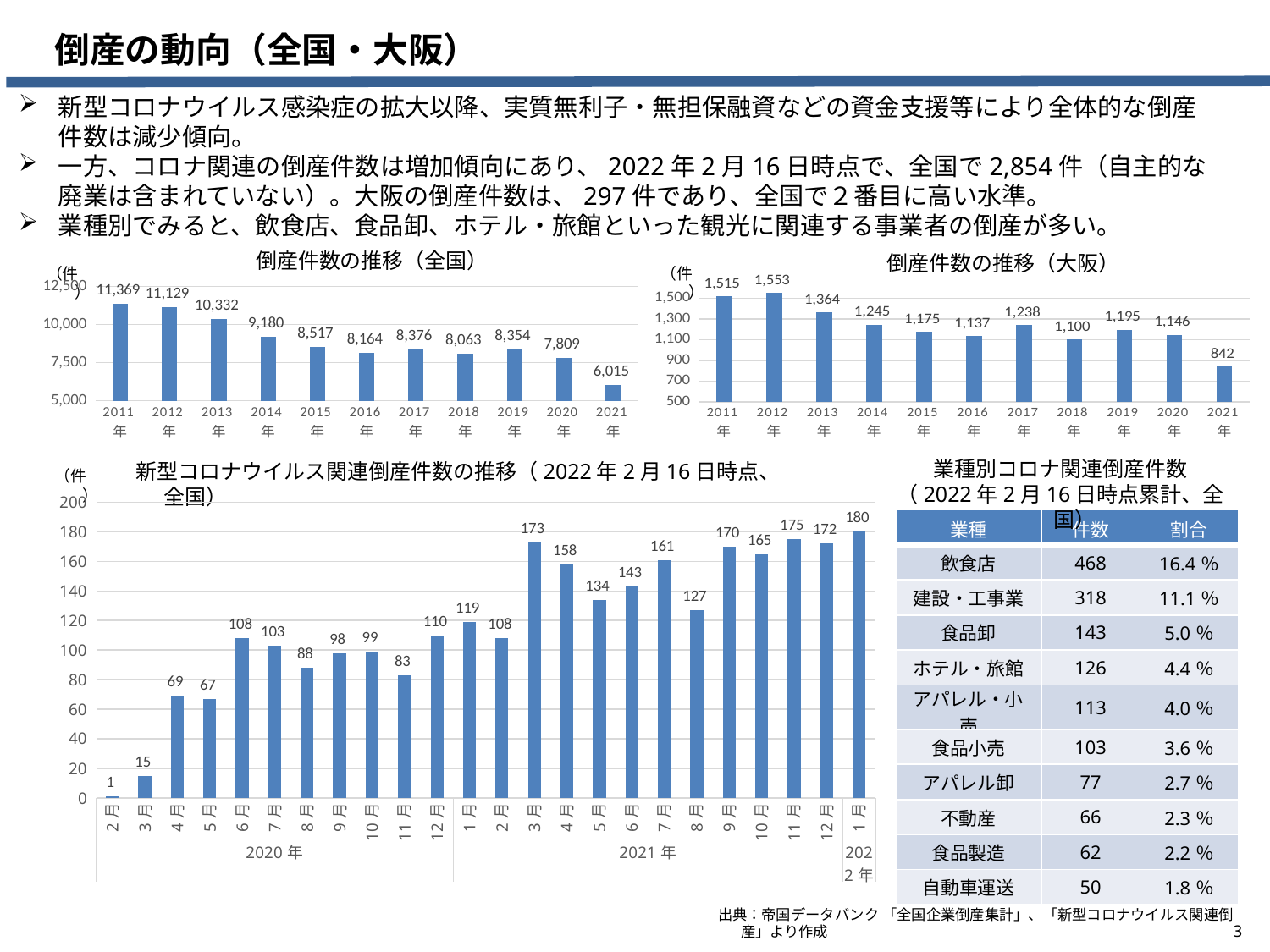
In the chart titled 倒産件数の推移（全国）, what is the difference between the values for 2011年 and 2012年? 240 What kind of chart is the chart titled 新型コロナウイルス関連倒産件数の推移? Bar chart In the chart titled 倒産件数の推移（全国）, how many bars are plotted? 11 In the chart titled 新型コロナウイルス関連倒産件数の推移, how many bars are plotted? 24 In the chart titled 倒産件数の推移（大阪）, which is larger, the value for 2017年 or the value for 2018年? 2017年 In the chart titled 新型コロナウイルス関連倒産件数の推移, what is the value for 3月 of 2021年? 173 In the chart titled 倒産件数の推移（大阪）, which year has the lowest value? 2021年 In the chart titled 倒産件数の推移（全国）, which year has the highest value? 2011年 In the chart titled 倒産件数の推移（大阪）, what is the value for 2012年? 1,553 In the chart titled 新型コロナウイルス関連倒産件数の推移, which month has the highest value? 1月 of 2022年 In the chart titled 倒産件数の推移（全国）, what is the value for 2021年? 6,015 In the chart titled 倒産件数の推移（大阪）, what is the difference between the values for 2020年 and 2021年? 304